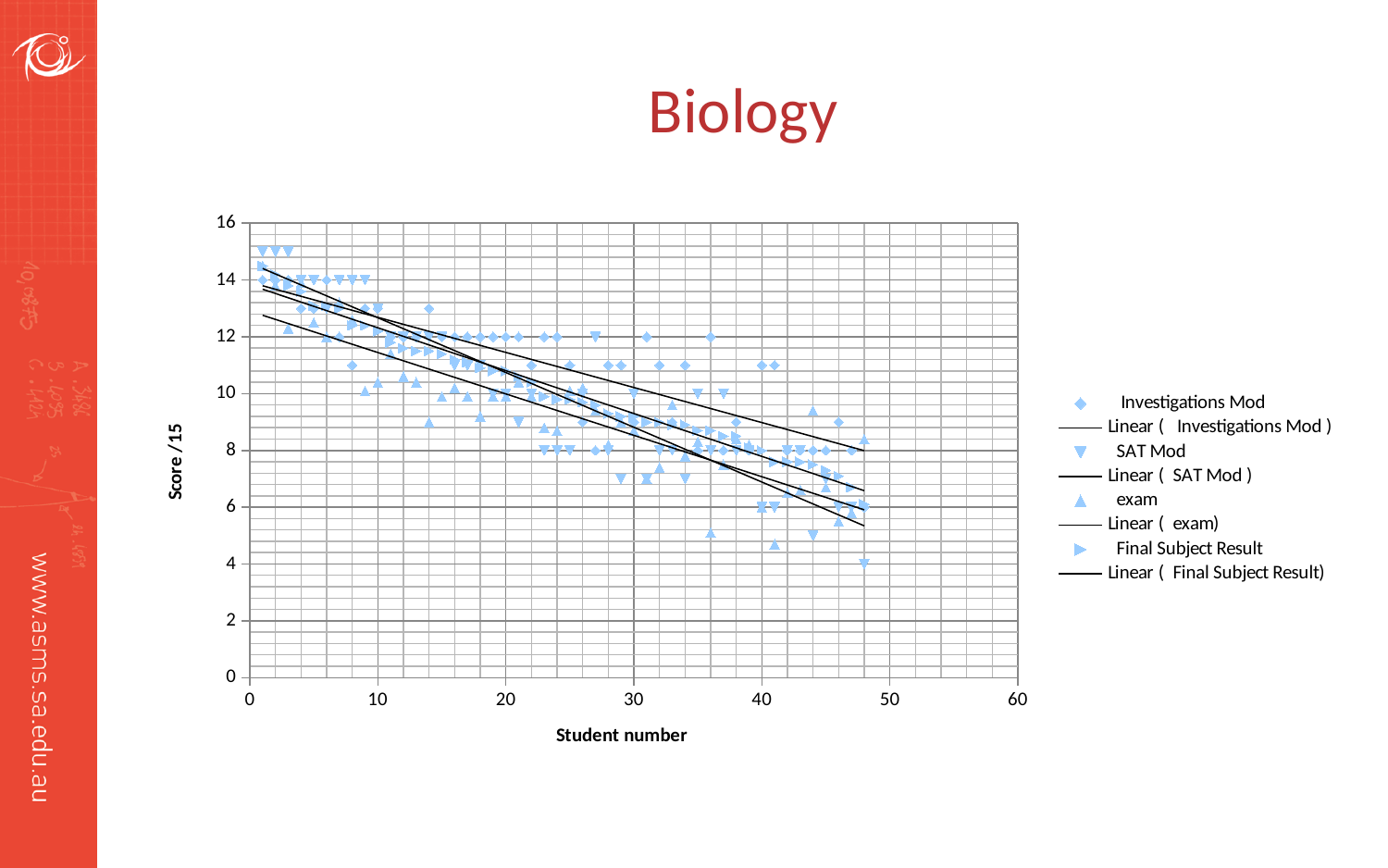
As the student number increases along the x axis, do the scores generally rise or fall? Fall Is the lowest plotted point on the chart greater or less than 6? less What kind of chart is shown on the slide? Scatter chart What is the title of the chart? Biology What is the label on the vertical axis of the chart? Score /15 Do the linear trend lines on the chart slope upward or downward? Downward What is the maximum value shown on the y axis? 16 How many entries does the chart's legend list? 8 What is the maximum value shown on the x axis? 60 Is the highest SAT Mod point on the chart greater or less than 14? greater How many data series (excluding the linear trend lines) does the legend list? 4